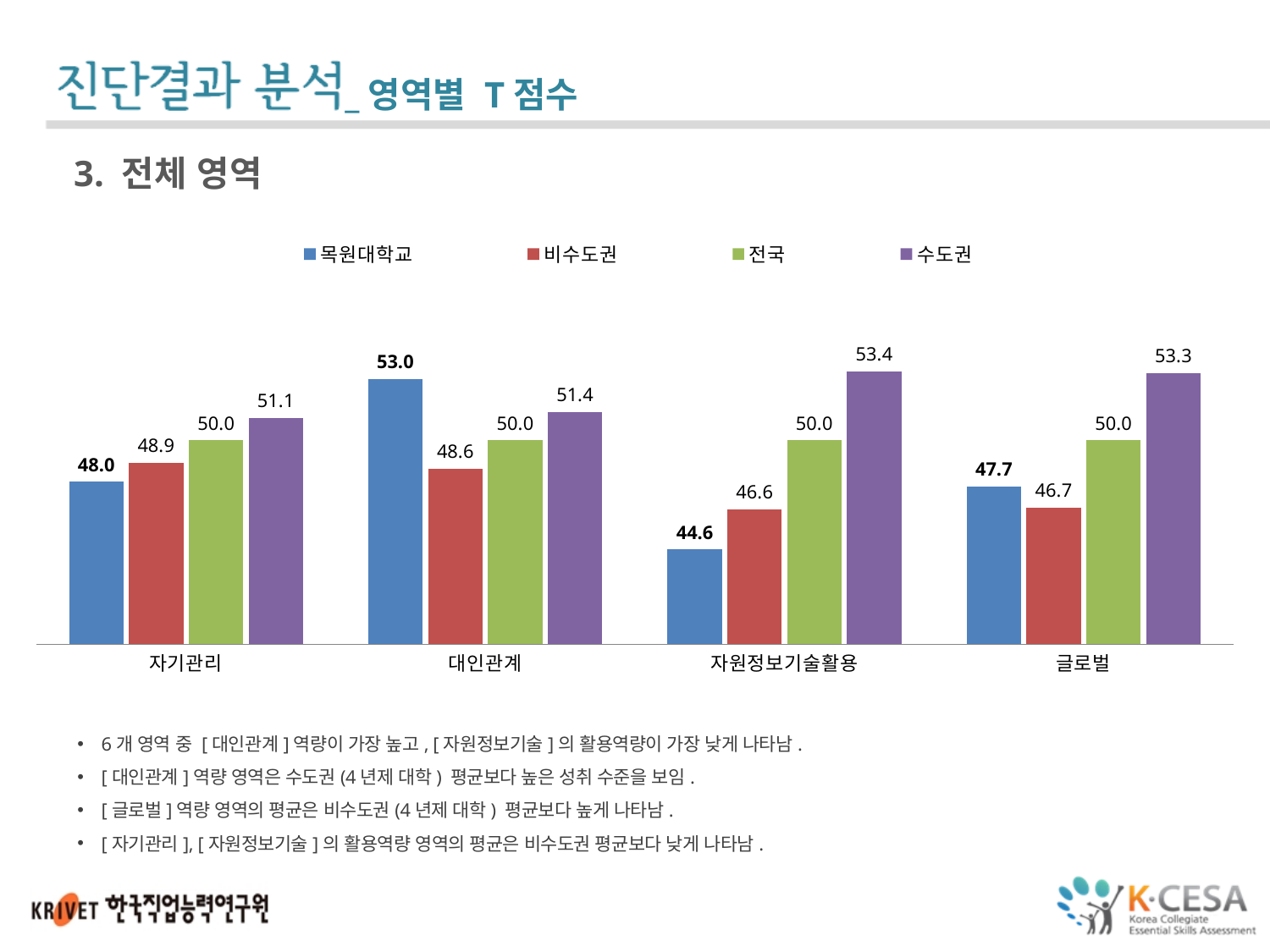
What is the value for 목원대학교 in the 자원정보기술활용 category? 44.6 How many series does the legend list? 4 Which is larger in the 자기관리 category: the 목원대학교 value or the 수도권 value? 수도권 What is the difference between the 수도권 and 목원대학교 values in the 자원정보기술활용 category? 8.8 How many categories are shown on the x axis of the chart? 4 What kind of chart is shown on the slide? bar chart In which category does 목원대학교 have its highest value? 대인관계 What is the value for 비수도권 in the 글로벌 category? 46.7 In which category does 목원대학교 have its lowest value? 자원정보기술활용 What is the value for 수도권 in the 대인관계 category? 51.4 Which is larger in the 글로벌 category: the 목원대학교 value or the 비수도권 value? 목원대학교 What is the difference between the 목원대학교 and 비수도권 values in the 대인관계 category? 4.4